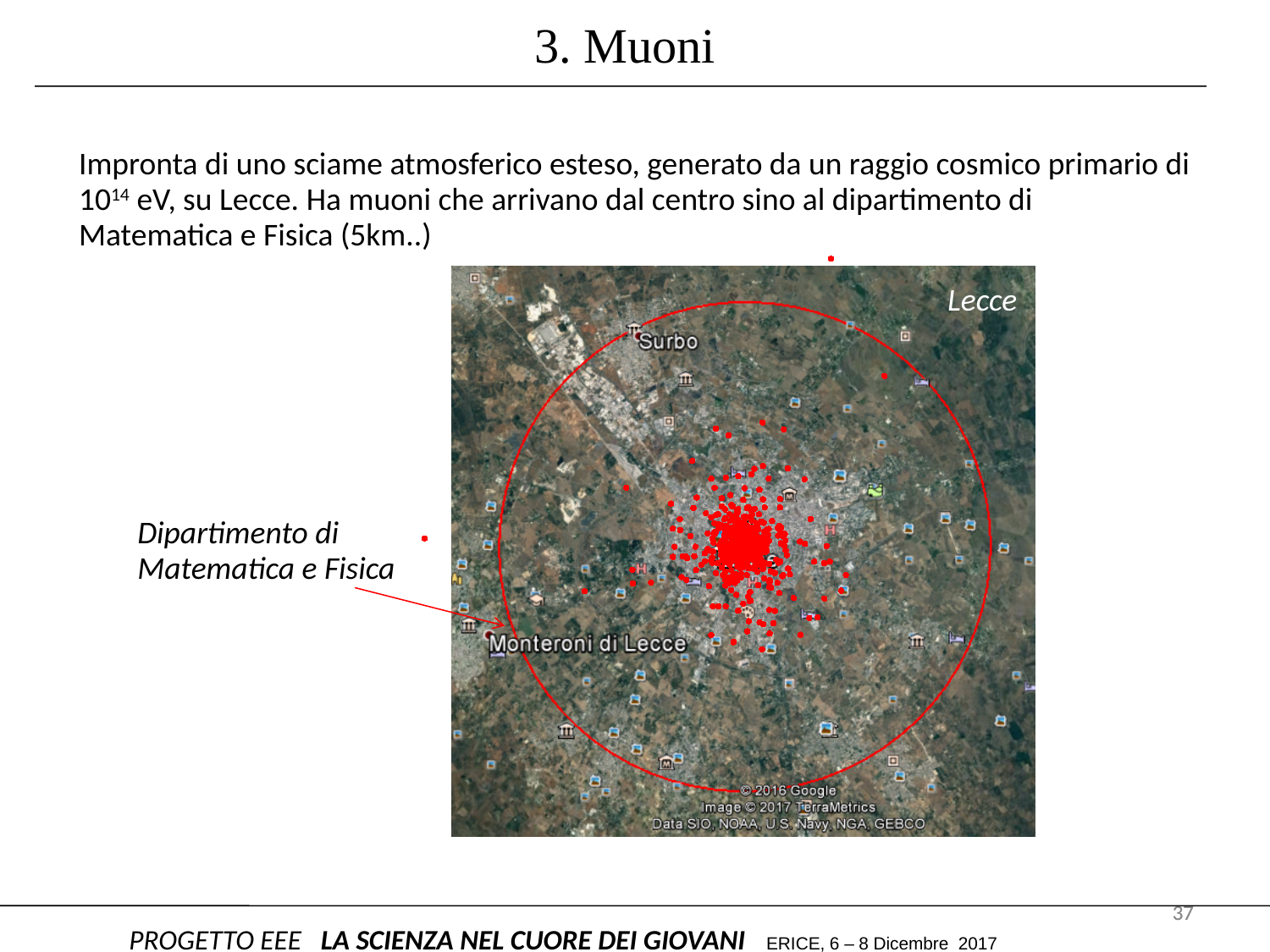
Where on the map are the red points most densely concentrated? In the centre of Lecce, at the middle of the red circle What colour are the plotted points on the map of Lecce? Red What location does the red arrow on the left of the map point to? Dipartimento di Matematica e Fisica Which city is named in the top-right corner of the map? Lecce